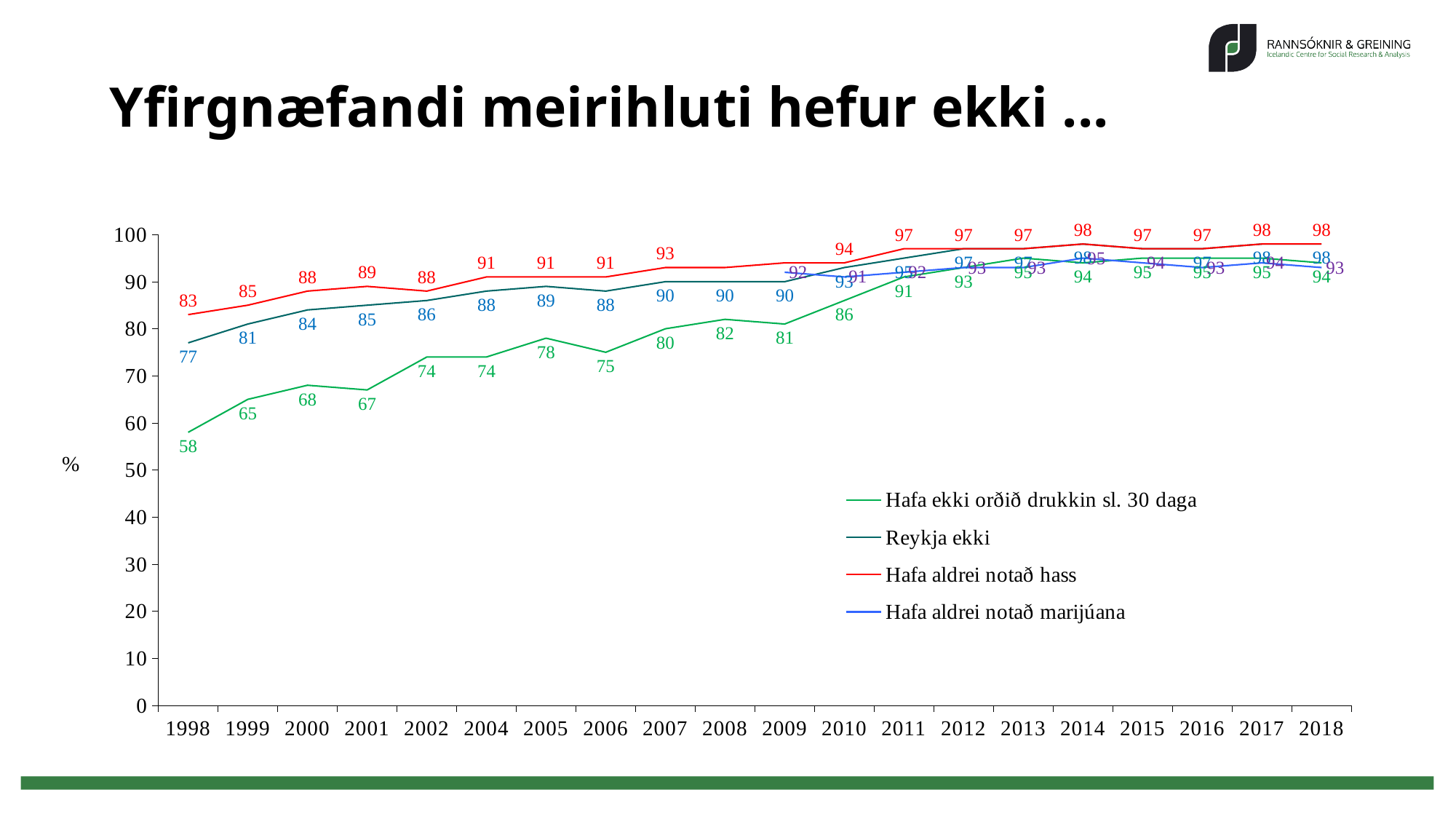
What is the value for 'Hafa ekki orðið drukkin sl. 30 daga' in 2009? 81 What is the value for 'Hafa aldrei notað hass' in 1998? 83 What is the value for 'Reykja ekki' in 1998? 77 How many series does the legend list? 4 What is the value for 'Hafa ekki orðið drukkin sl. 30 daga' in 1998? 58 How many years are shown on the x axis? 20 Does 'Hafa ekki orðið drukkin sl. 30 daga' generally rise or fall from 1998 to 2018? rise What type of chart is shown on the slide? line chart What is the value for 'Hafa aldrei notað hass' in 2018? 98 What is the difference between 'Hafa aldrei notað hass' and 'Hafa ekki orðið drukkin sl. 30 daga' in 1998? 25 In which year is 'Hafa ekki orðið drukkin sl. 30 daga' lowest? 1998 In 2005, which is larger: 'Hafa aldrei notað hass' or 'Hafa ekki orðið drukkin sl. 30 daga'? Hafa aldrei notað hass